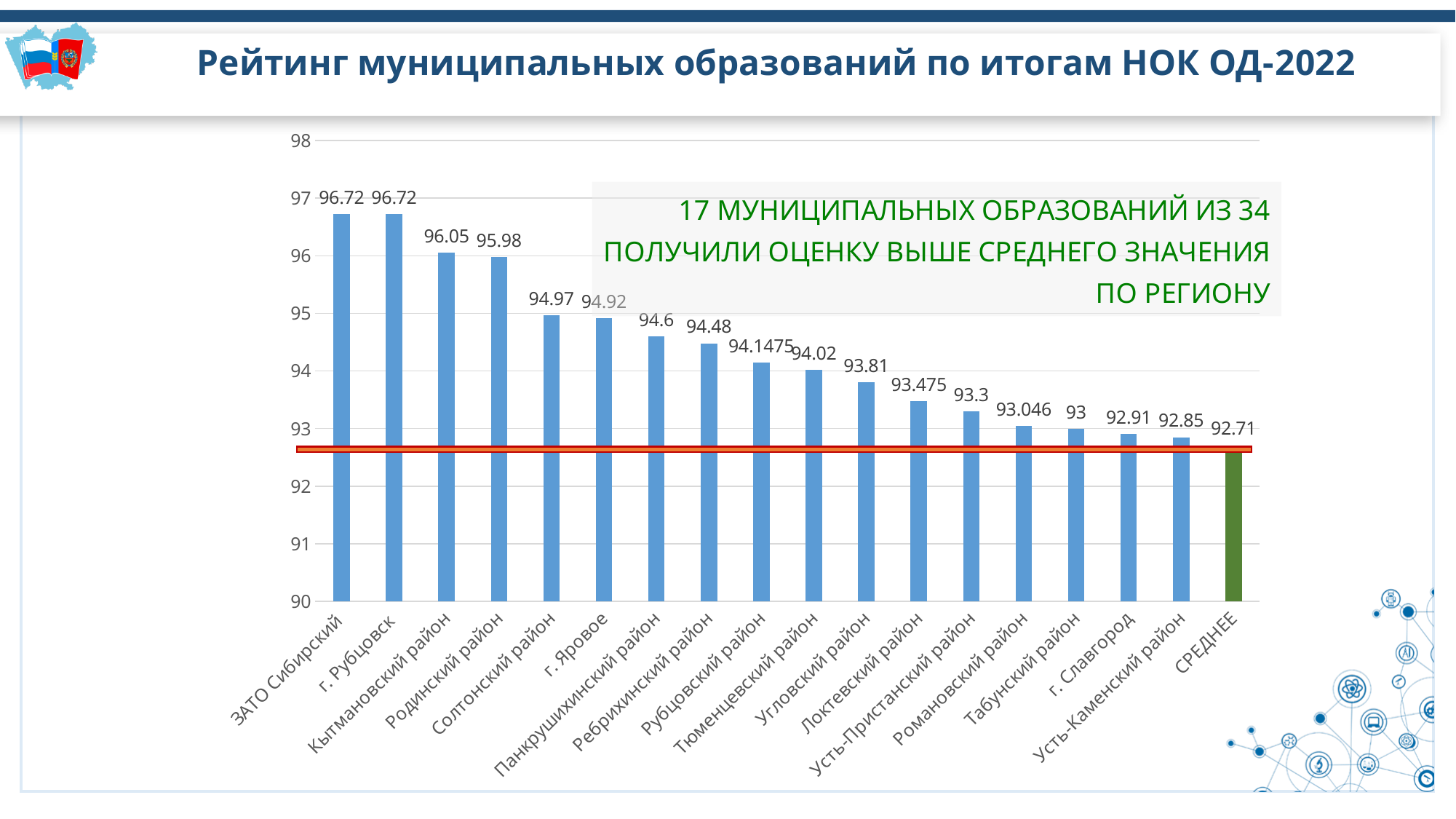
What value is shown for Кытмановский район? 96.05 Do the bar values rise or fall from left to right along the x axis? fall What kind of chart is shown on the slide? bar chart What colour is the СРЕДНЕЕ bar? green How many bars are plotted on the chart? 18 What value is shown for the СРЕДНЕЕ bar? 92.71 What value is shown for Рубцовский район? 94.1475 Which is larger, the value for Угловский район or the value for Локтевский район? Угловский район Which category has the lowest bar on the chart? СРЕДНЕЕ What value is shown for Солтонский район? 94.97 What is the difference between the values for Родинский район and Табунский район? 2.98 Is the value for г. Славгород greater or less than 93? less